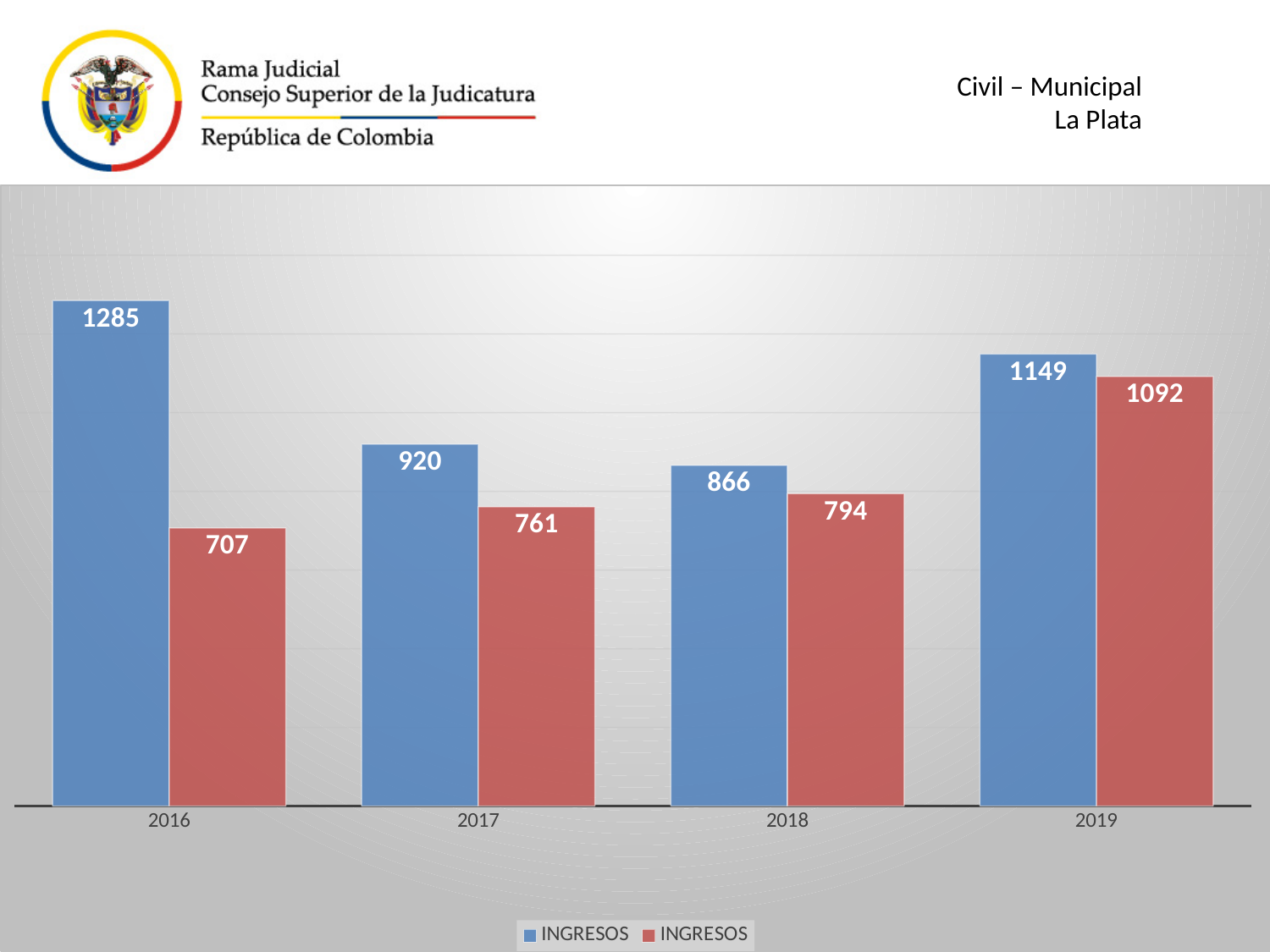
What is the value of the red bar for 2019? 1092 Which is larger in 2017, the blue bar or the red bar? the blue bar What is the value of the blue bar for 2016? 1285 What is the difference between the blue bar and the red bar in 2019? 57 In which year is the red bar the lowest? 2016 How many series does the legend list? 2 In which year is the blue bar the highest? 2016 What is the value of the red bar for 2018? 794 What kind of chart is shown on the slide? bar chart How many years are shown on the x axis? 4 Do the red bars rise or fall from 2016 to 2019? rise What is the difference between the blue bar and the red bar in 2016? 578